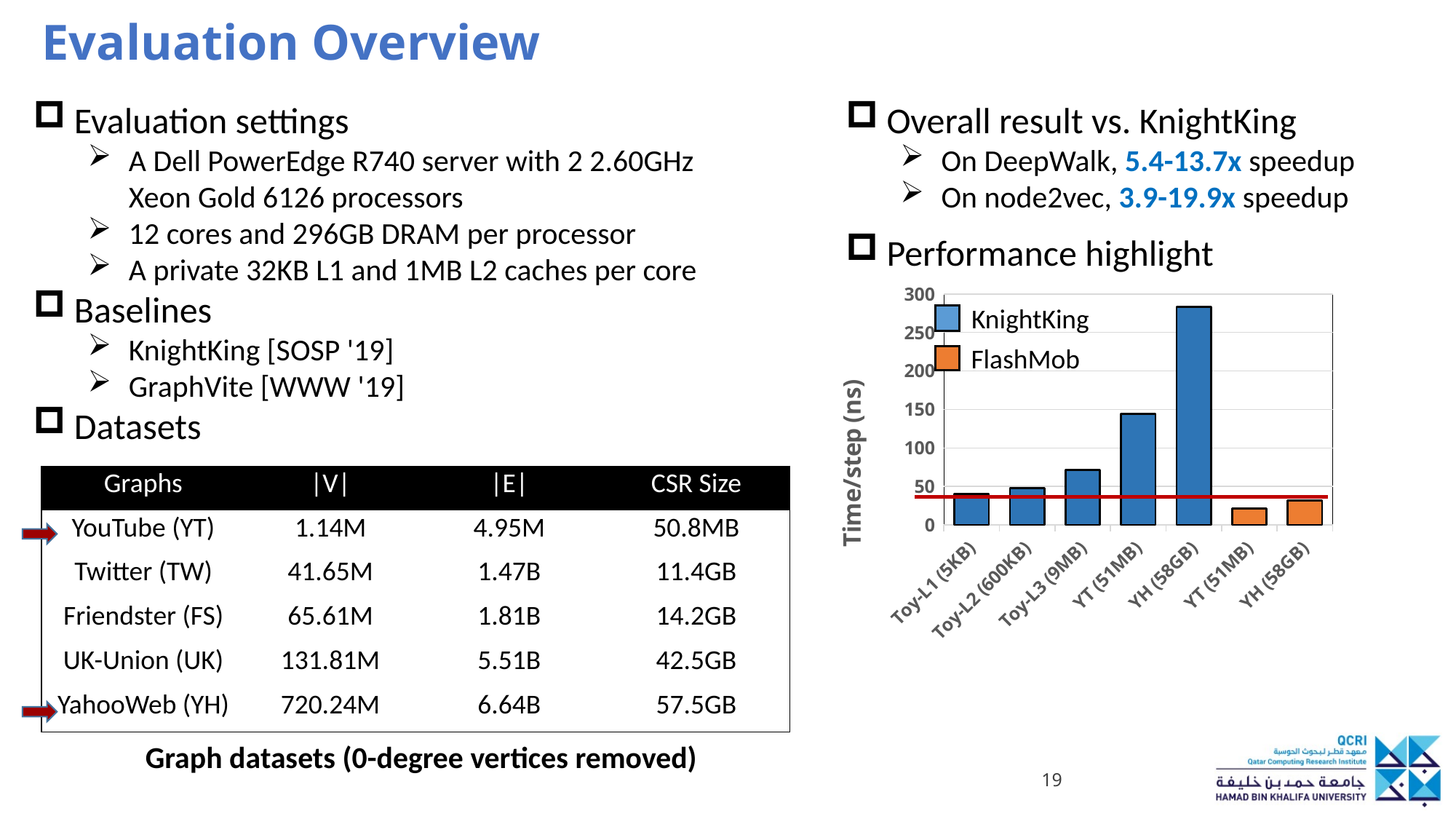
What is the label of the y axis in the Performance highlight chart? Time/step (ns) Is the KnightKing value for YT (51MB) greater or less than 100 ns? greater Do the KnightKing bars rise or fall going from Toy-L1 (5KB) to YH (58GB) along the x axis? rise How many series does the legend of the Performance highlight chart list? 2 Which two series are listed in the legend of the Performance highlight chart? KnightKing and FlashMob Which is larger in the Performance highlight chart: the KnightKing bar for YT (51MB) or the FlashMob bar for YT (51MB)? KnightKing bar for YT (51MB) Is the KnightKing value for YH (58GB) greater or less than 250 ns? greater How many bars are plotted in the Performance highlight chart? 7 What kind of chart is shown under "Performance highlight"? bar chart Which bar is the highest in the Performance highlight chart? KnightKing on YH (58GB) Is the KnightKing value for Toy-L3 (9MB) greater or less than 100 ns? less